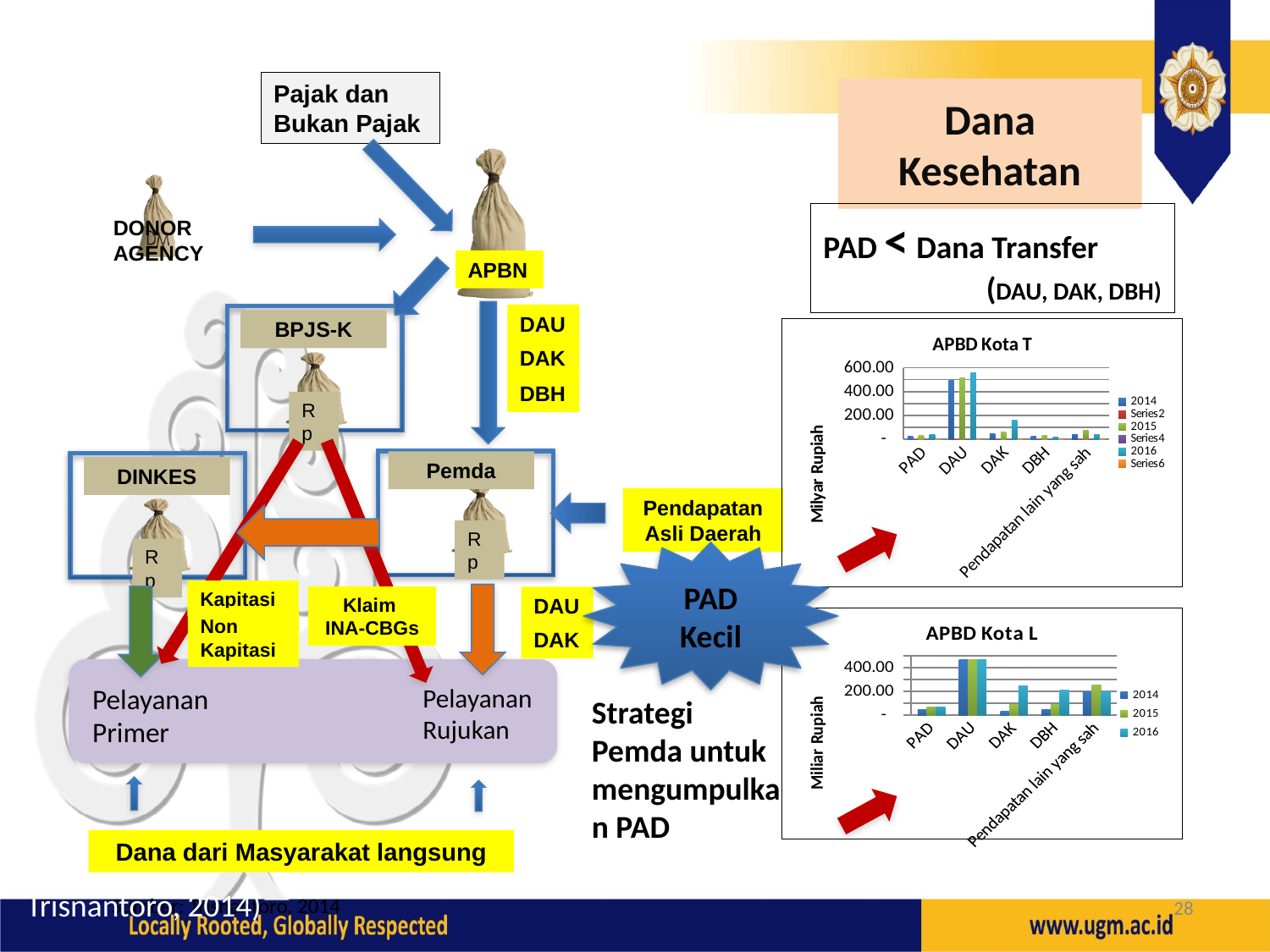
How many series does the legend of the "APBD Kota L" chart list? 3 In the "APBD Kota T" chart, is the 2014 value for DAU greater or less than 400.00? greater In the "APBD Kota L" chart, is the 2014 value for DAU greater or less than 400.00? greater In the "APBD Kota T" chart, is the 2014 value for PAD greater or less than 200.00? less What type of chart is the "APBD Kota T" chart? bar chart What is the y-axis label of the "APBD Kota L" chart? Miliar Rupiah In the "APBD Kota T" chart, which category has the highest values? DAU How many categories are shown on the x axis of the "APBD Kota L" chart? 5 In the "APBD Kota L" chart, which category has the highest values? DAU How many series does the legend of the "APBD Kota T" chart list? 6 In the "APBD Kota L" chart, which is larger, the 2016 value for DAU or the 2016 value for PAD? DAU